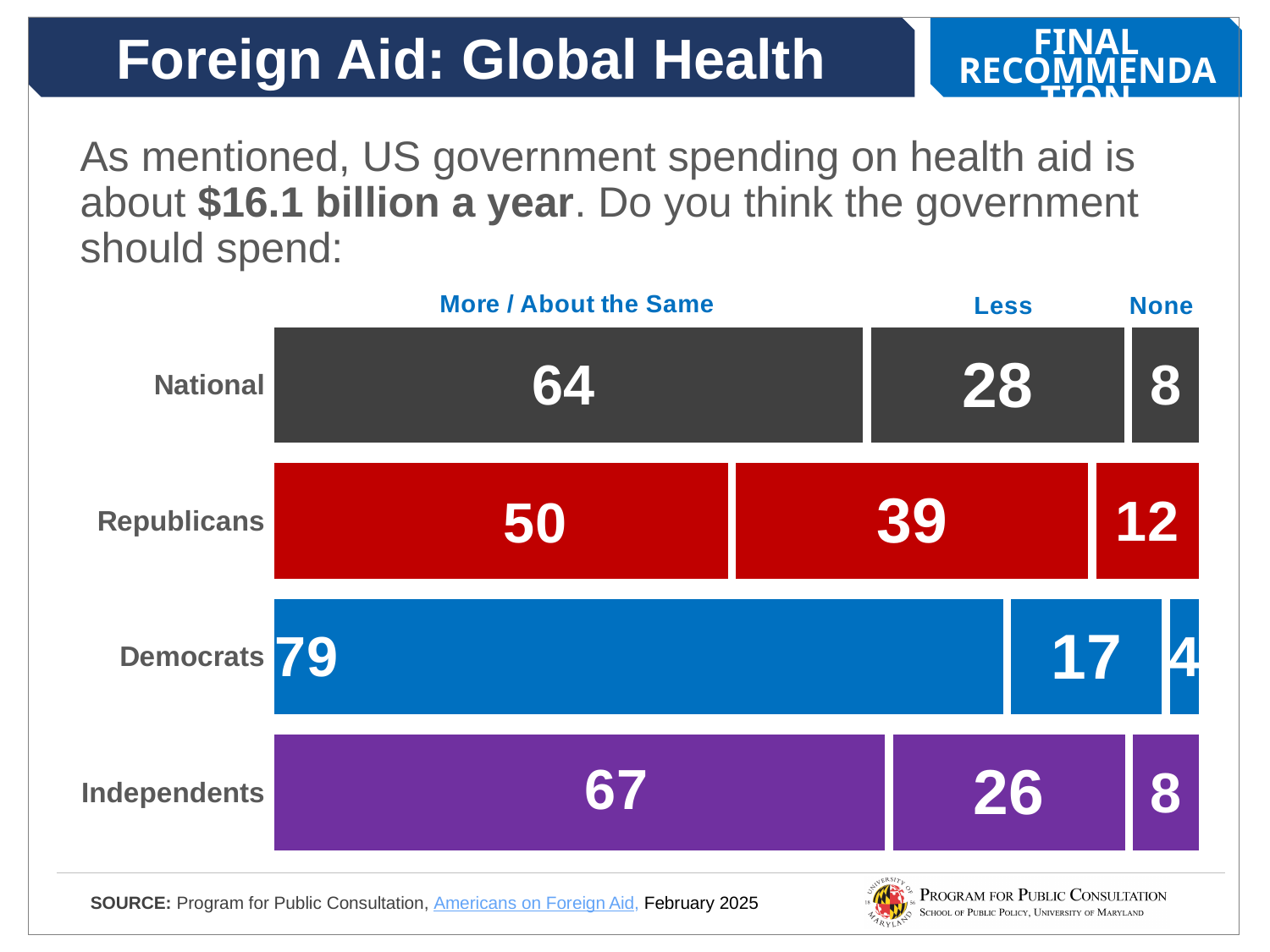
What is the total of the Republicans bar across all three series? 101 What is the difference between the Democrats and Republicans values for More / About the Same? 29 What is the value for Democrats in the None series? 4 Which is larger: the Less value for Republicans or the Less value for Independents? Republicans What is the value for National in the More / About the Same series? 64 How many series does the chart show? 3 How many groups (categories) are shown in the chart? 4 Which group has the lowest value for More / About the Same? Republicans What is the value for Republicans in the Less series? 39 Which group has the highest value for More / About the Same? Democrats What kind of chart is shown on the slide? Stacked horizontal bar chart What is the value for Independents in the Less series? 26